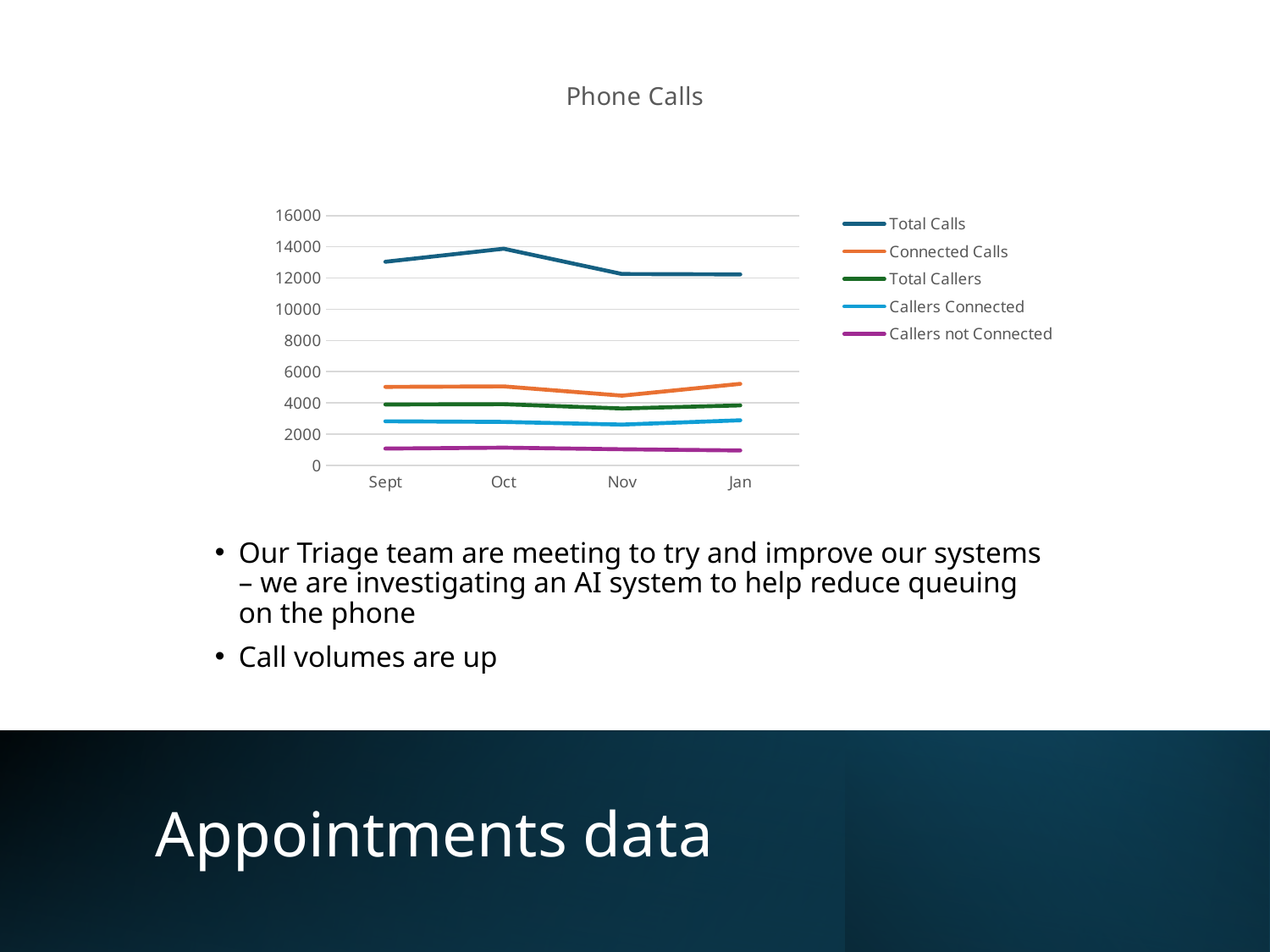
Is the value for Callers not Connected in Jan greater or less than 2000? less Which series is drawn in purple on the chart? Callers not Connected What is the title of the chart? Phone Calls Is the value for Total Calls in Oct greater or less than 12000? greater In which month is the Connected Calls series at its lowest? Nov Does the Total Calls series rise or fall from Oct to Nov? Fall How many months are shown along the x axis of the chart? 4 In which month is the Total Calls series at its highest? Oct Is the value for Connected Calls in Nov greater or less than 6000? less In Sept, which is larger: Total Calls or Connected Calls? Total Calls How many series does the chart's legend list? 5 What kind of chart is shown on the slide? Line chart